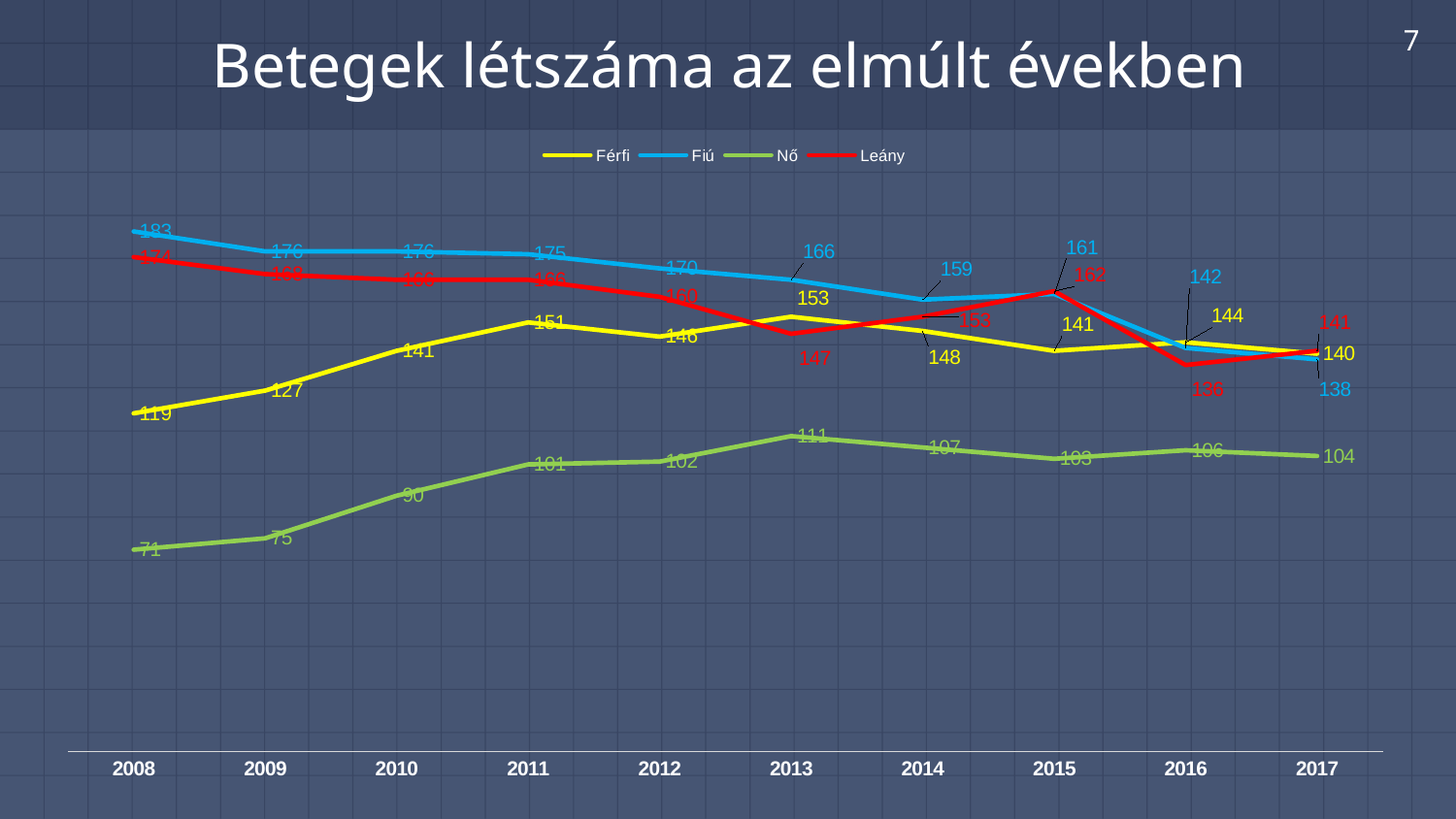
How many years are shown on the x axis? 10 How many series does the legend list? 4 In 2014, which is larger: Férfi or Leány? Leány What is the value for Leány in 2016? 136 Does the Fiú series generally rise or fall from 2008 to 2017? fall What is the difference between the Fiú value in 2008 and in 2017? 45 What is the value for Fiú in 2017? 138 What kind of chart is shown on the slide? line chart What is the value for Férfi in 2013? 153 In which year is the Fiú series at its lowest? 2017 In which year is the Nő series at its highest? 2013 What is the value for Nő in 2008? 71